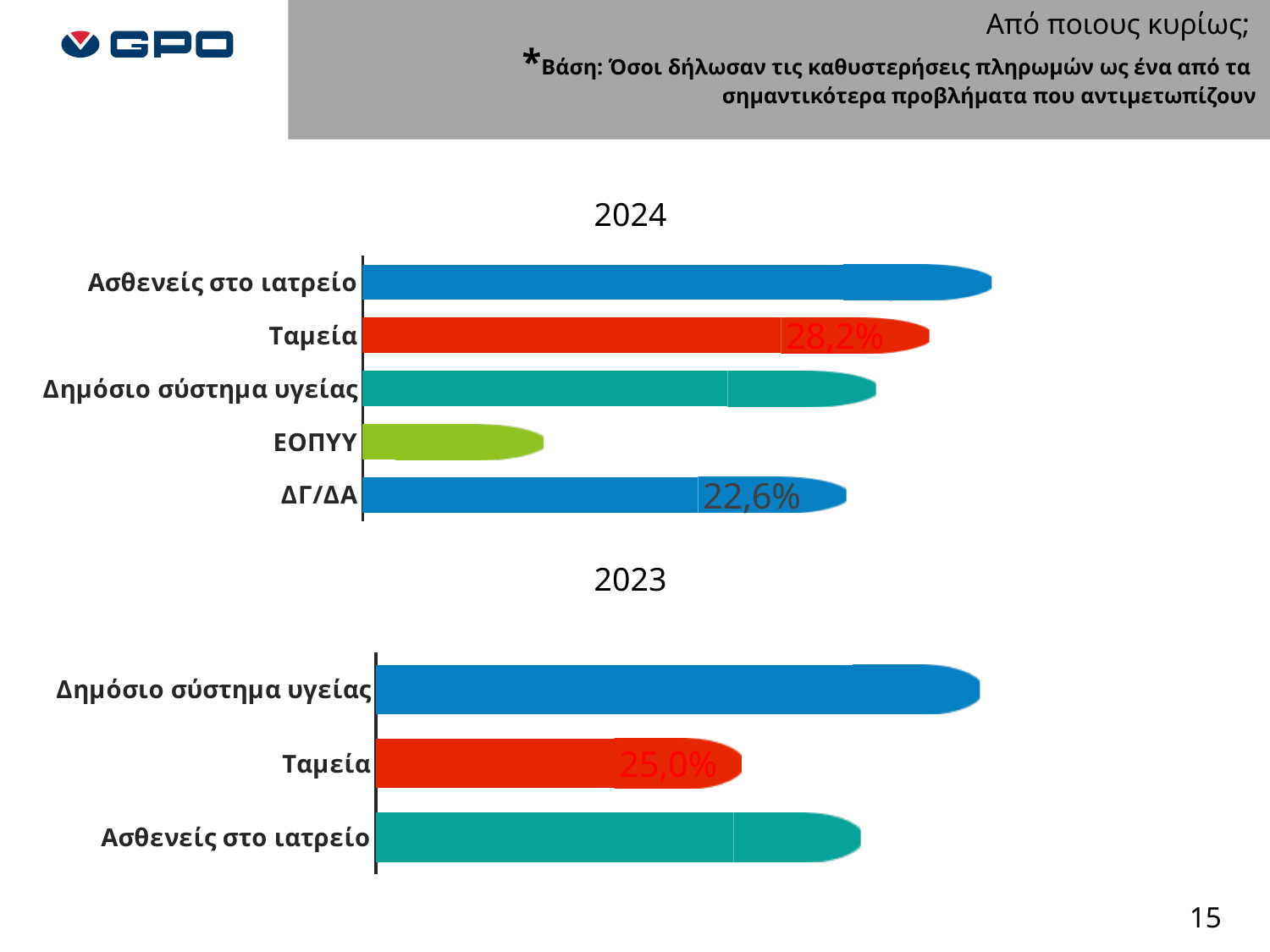
In the 2023 chart, how many categories are shown? 3 What kind of chart is the 2024 chart? Bar chart In the 2024 chart, which category has the lowest value? ΕΟΠΥΥ In the 2023 chart, what is the value for Ταμεία? 25,0% In the 2024 chart, which is larger: Ταμεία or Δημόσιο σύστημα υγείας? Ταμεία In the 2024 chart, what is the value for ΔΓ/ΔΑ? 22,6% In the 2023 chart, which category has the highest value? Δημόσιο σύστημα υγείας In the 2024 chart, how many categories are shown? 5 In the 2024 chart, which category has the highest value? Ασθενείς στο ιατρείο In the 2024 chart, what is the value for Ταμεία? 28,2% In the 2023 chart, which category has the lowest value? Ταμεία In the 2024 chart, what is the difference between the values for Ταμεία and ΔΓ/ΔΑ? 5,6%